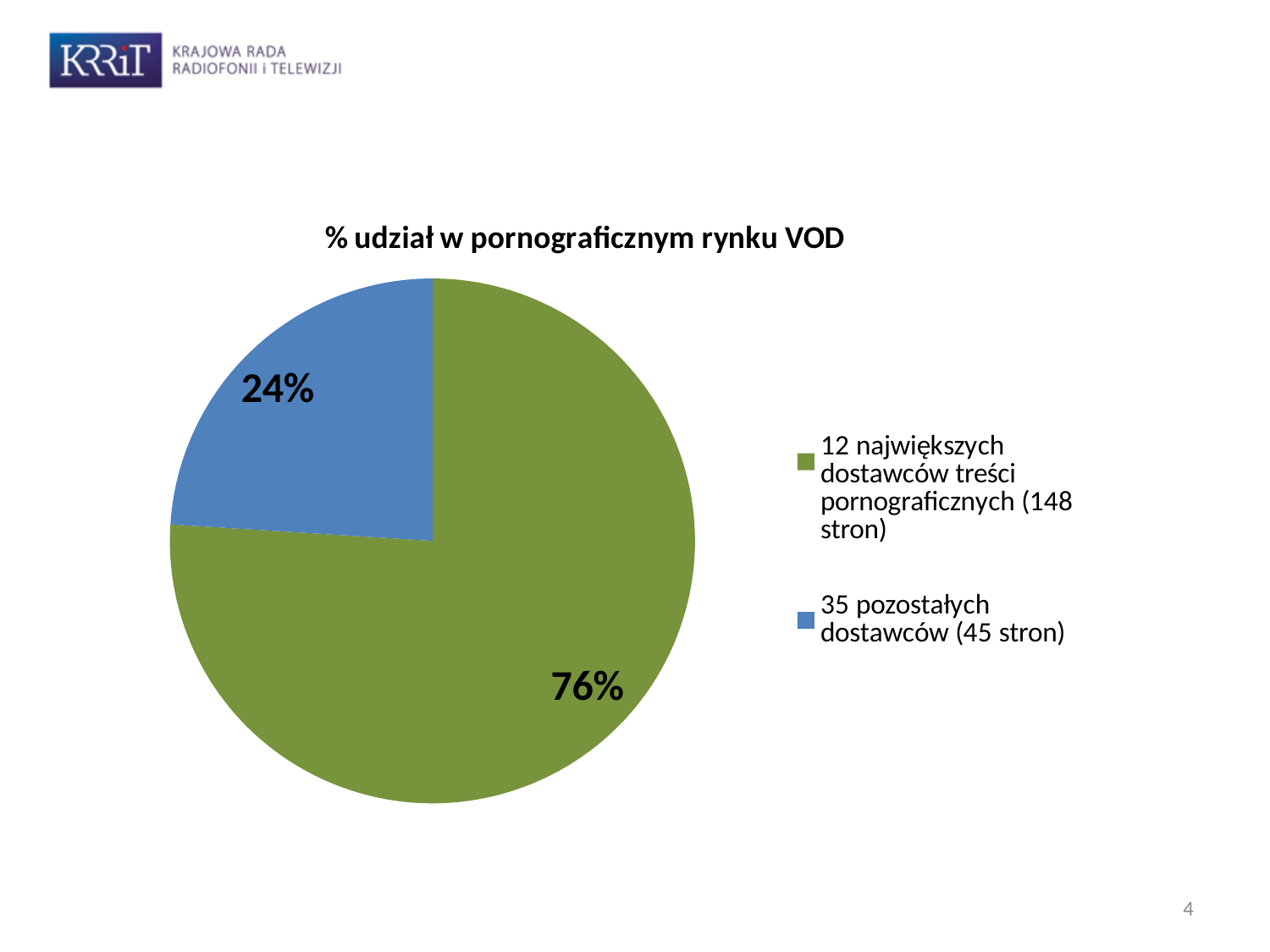
What share of the pie does '12 największych dostawców treści pornograficznych (148 stron)' have? 76% Which category has the smallest share of the pie? 35 pozostałych dostawców (45 stron) Which is larger: the share of '12 największych dostawców treści pornograficznych (148 stron)' or the share of '35 pozostałych dostawców (45 stron)'? 12 największych dostawców treści pornograficznych (148 stron) How many entries does the legend list? 2 How many slices does the pie chart have? 2 What colour is the slice for '35 pozostałych dostawców (45 stron)'? blue What is the chart's title? % udział w pornograficznym rynku VOD What share of the pie does '35 pozostałych dostawców (45 stron)' have? 24% What kind of chart is shown on the slide? pie chart Which category has the largest share of the pie? 12 największych dostawców treści pornograficznych (148 stron) What is the difference in percentage points between the share of the 12 largest providers and the share of the 35 remaining providers? 52